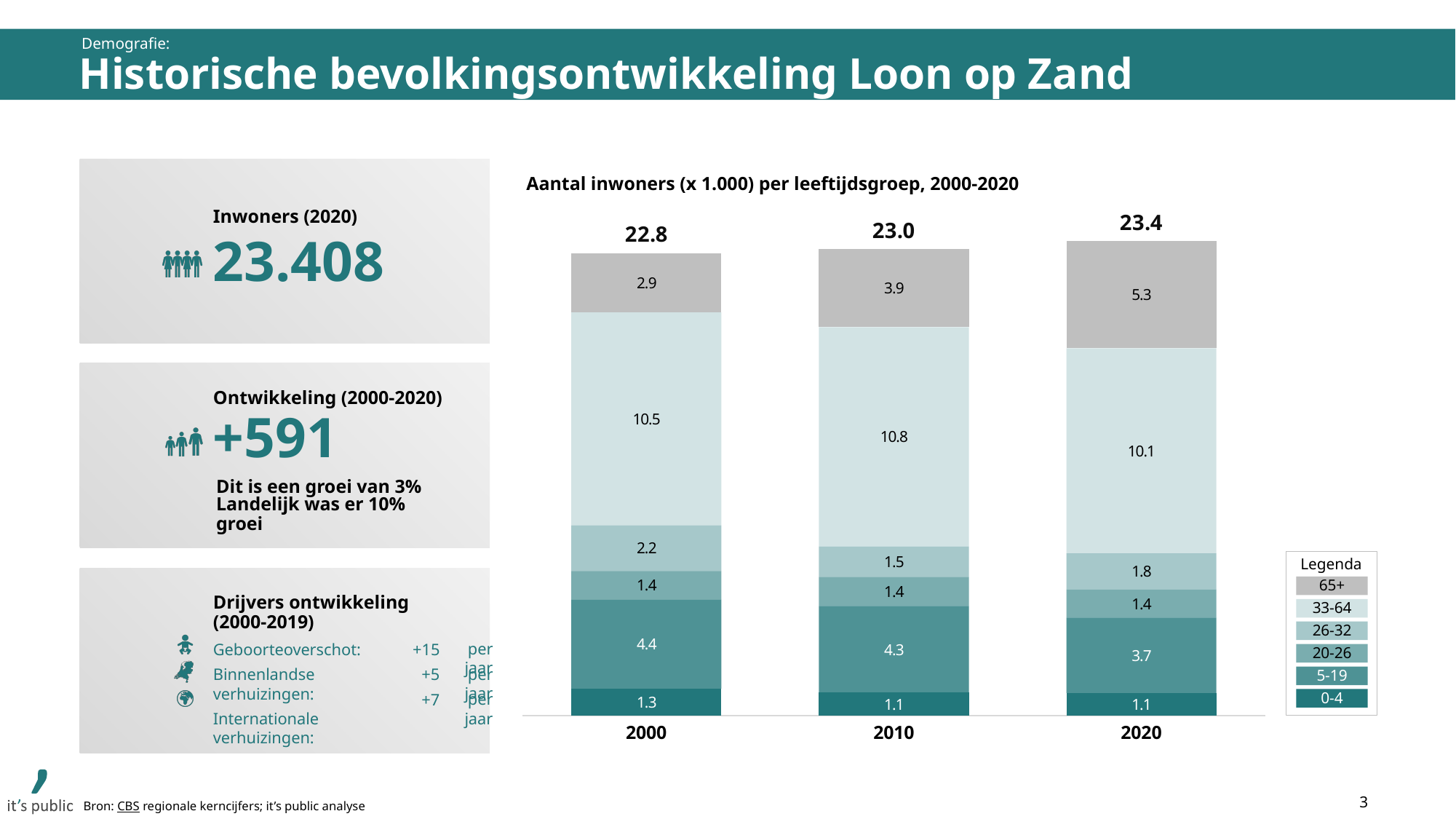
Which year has the highest total number of inhabitants? 2020 How many years (categories) are shown on the x axis? 3 What type of chart is shown on the slide? Stacked bar chart Which year has the lowest value for the 65+ age group? 2000 Which is larger: the 5-19 value in 2000 or the 5-19 value in 2020? 2000 What is the value for the 5-19 age group in 2000? 4.4 What is the total shown above the bar for 2020? 23.4 What is the value for the 33-64 age group in 2010? 10.8 Does the value for the 65+ age group rise or fall from 2000 to 2020? Rise What is the difference between the 65+ value in 2020 and in 2000? 2.4 What is the value for the 65+ age group in 2020? 5.3 How many age groups does the legend list? 6